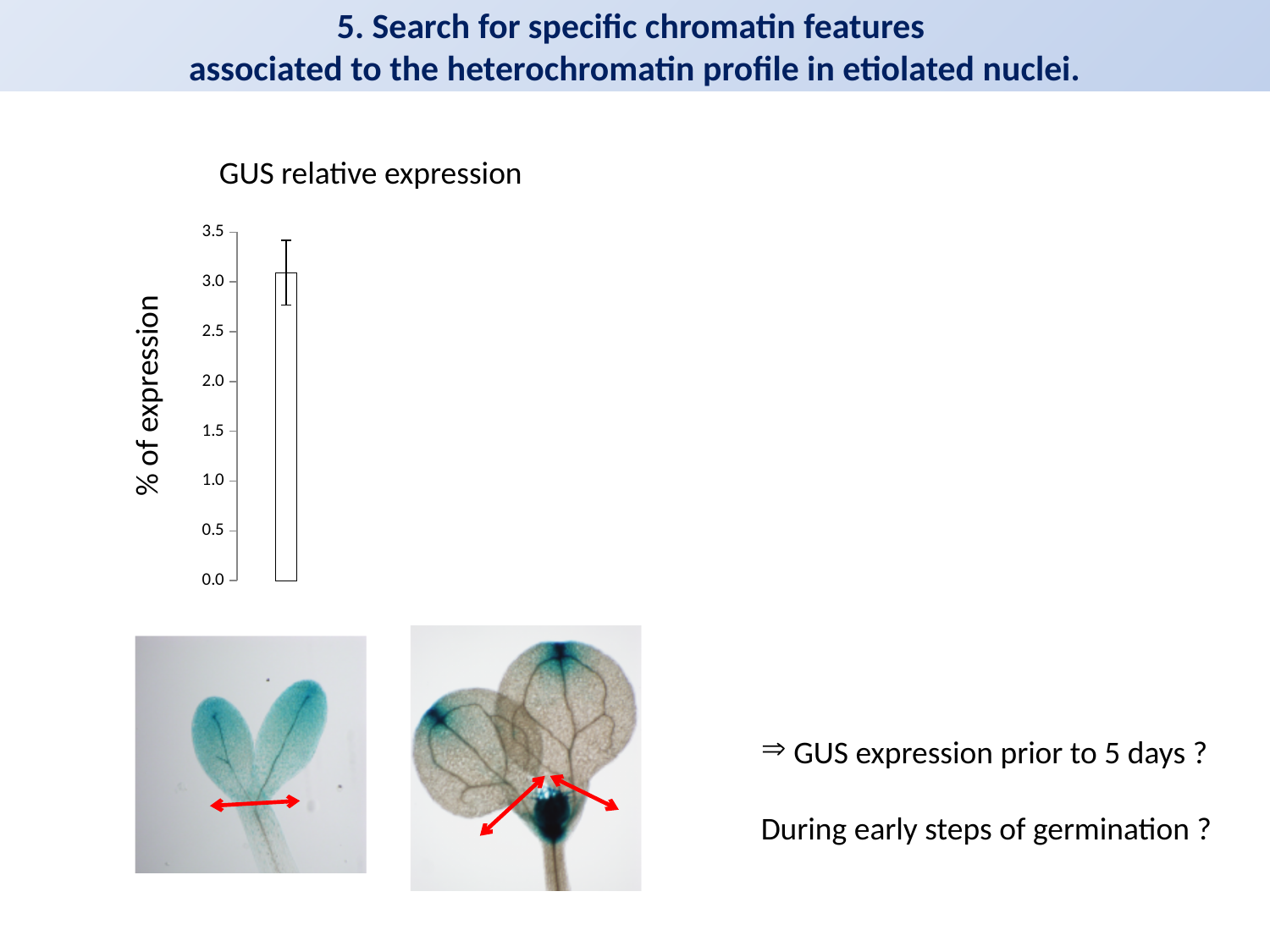
What is the label of the y axis of the chart? % of expression What kind of chart is shown on the slide? bar chart Is the value of the bar in the chart greater or less than 2.0? greater What is the title of the chart? GUS relative expression Is the value of the bar in the chart greater or less than 3.5? less How many bars are plotted in the chart? 1 Is the value of the bar in the chart greater or less than 2.5? greater